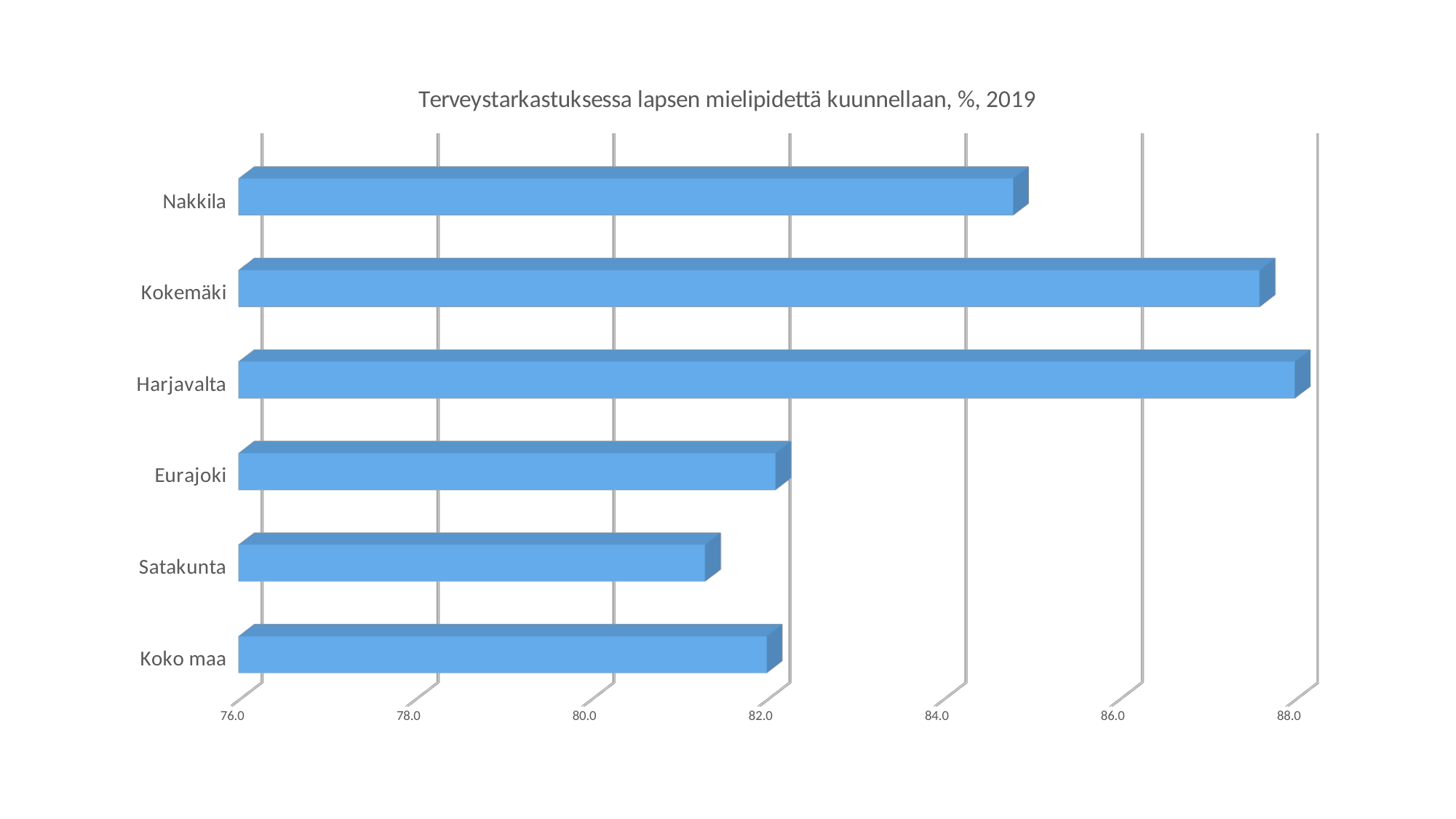
Which category has the lowest value? Satakunta Is the value for Nakkila greater or less than 84.0? greater Which has the larger value, Satakunta or Nakkila? Nakkila Which has the larger value, Nakkila or Kokemäki? Kokemäki Is the value for Kokemäki greater or less than 86.0? greater How many categories are shown in the chart? 6 Is the value for Harjavalta greater or less than 86.0? greater Which category has the highest value? Harjavalta What is the title of the chart? Terveystarkastuksessa lapsen mielipidettä kuunnellaan, %, 2019 What kind of chart is shown on the slide? bar chart